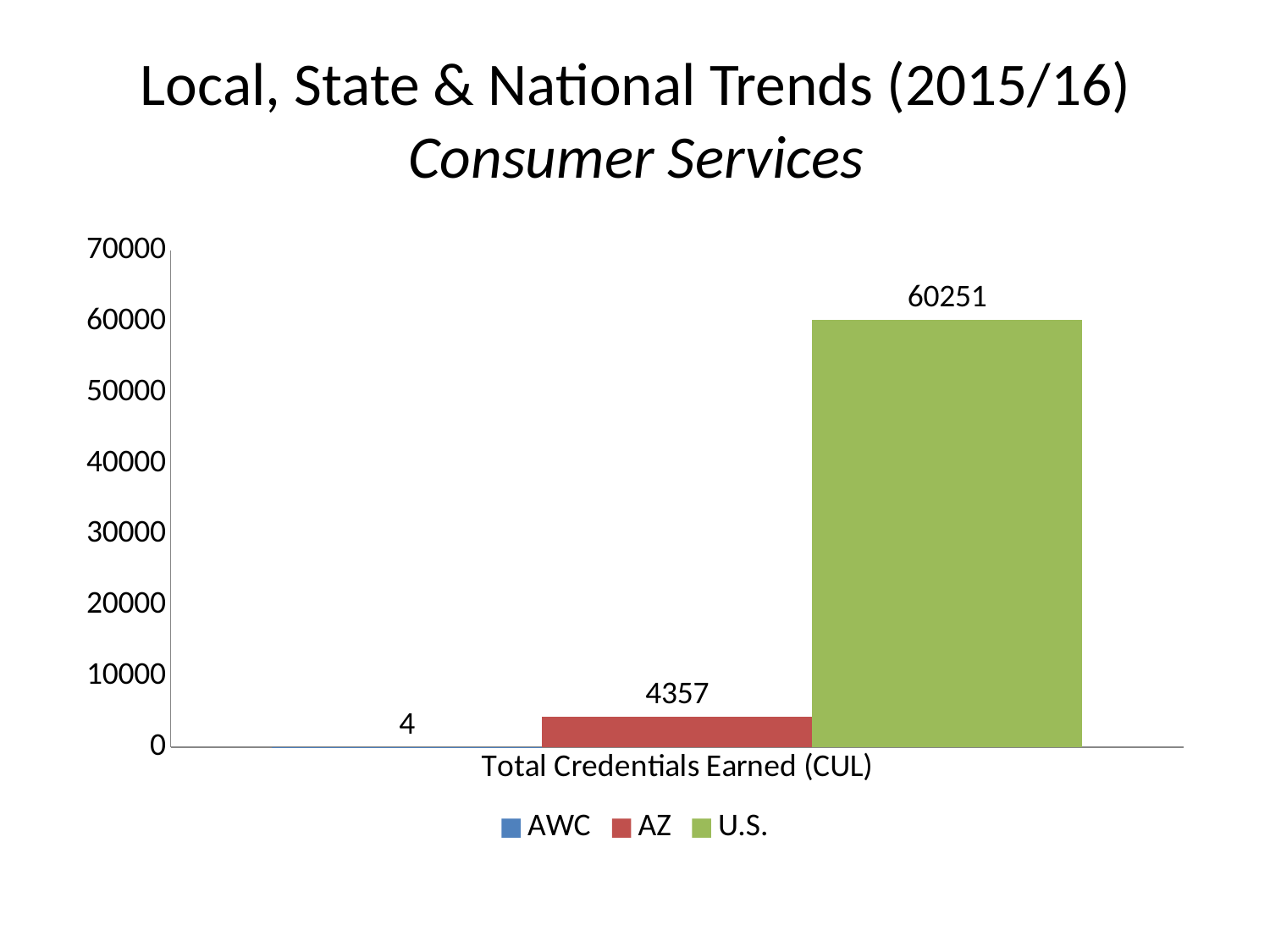
Which is larger, the value for AZ or the value for AWC? AZ What is the value for AWC in Total Credentials Earned (CUL)? 4 What kind of chart is shown on the slide? bar chart What is the difference between the U.S. value and the AZ value? 55894 What is the difference between the AZ value and the AWC value? 4353 Is the value for U.S. greater or less than 50000? greater What is the label of the category on the x axis? Total Credentials Earned (CUL) How many series does the legend list? 3 What is the value for U.S. in Total Credentials Earned (CUL)? 60251 Which series has the highest value for Total Credentials Earned (CUL)? U.S. What is the value for AZ in Total Credentials Earned (CUL)? 4357 Which series has the lowest value for Total Credentials Earned (CUL)? AWC